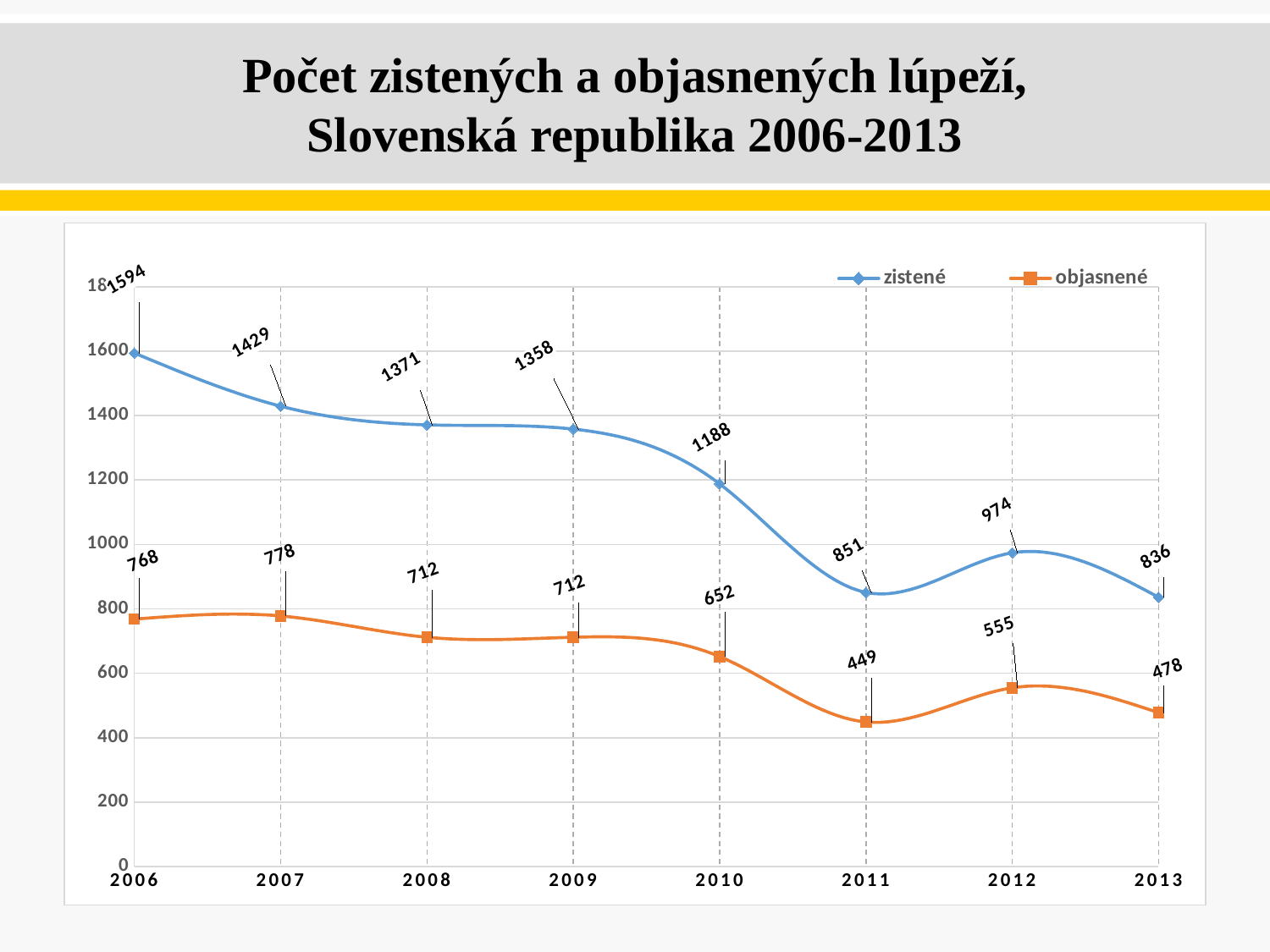
Which is larger: the objasnené value in 2012 or in 2013? 2012 Which series is drawn in orange? objasnené What is the difference between the zistené and objasnené values in 2010? 536 What kind of chart is shown on the slide? line chart What is the value of the zistené series in 2006? 1594 What is the value of the objasnené series in 2011? 449 In which year is the objasnené series highest? 2007 In which year is the zistené series lowest? 2011 How many series does the legend list? 2 Does the zistené series generally rise or fall from 2006 to 2011? fall What is the value of the zistené series in 2013? 836 How many years are plotted on the x axis? 8